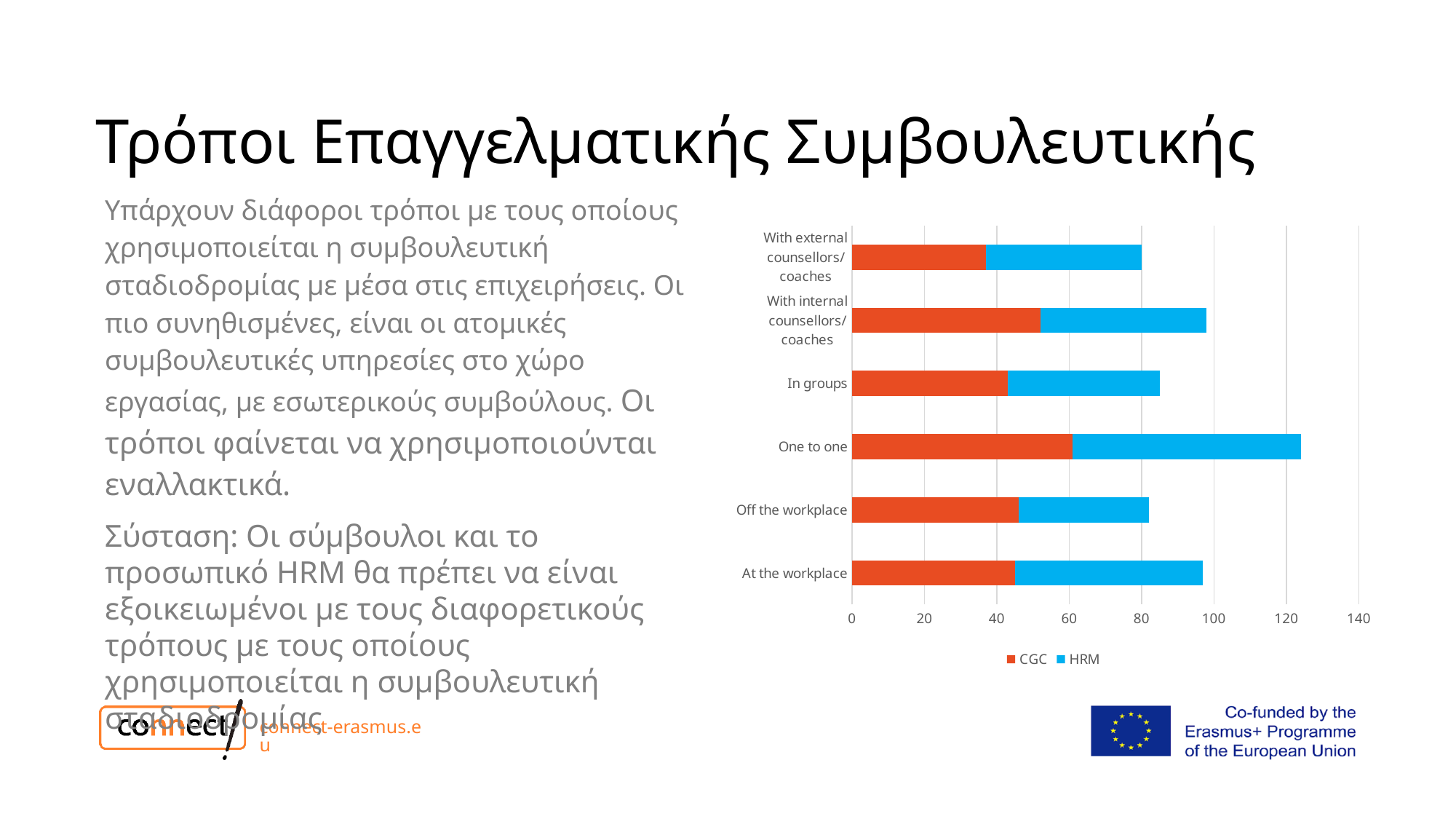
Which has the larger CGC value, One to one or In groups? One to one Which series is shown in orange-red in the legend? CGC What kind of chart is shown on the slide? stacked bar chart Which series is shown in blue in the legend? HRM Is the total bar for One to one greater or less than 120? greater How many categories are plotted on the chart? 6 Which category has the longest total bar? One to one Is the CGC value for With external counsellors/coaches greater or less than 40? less Which category has the shortest total bar? With external counsellors/coaches How many series does the chart legend list? 2